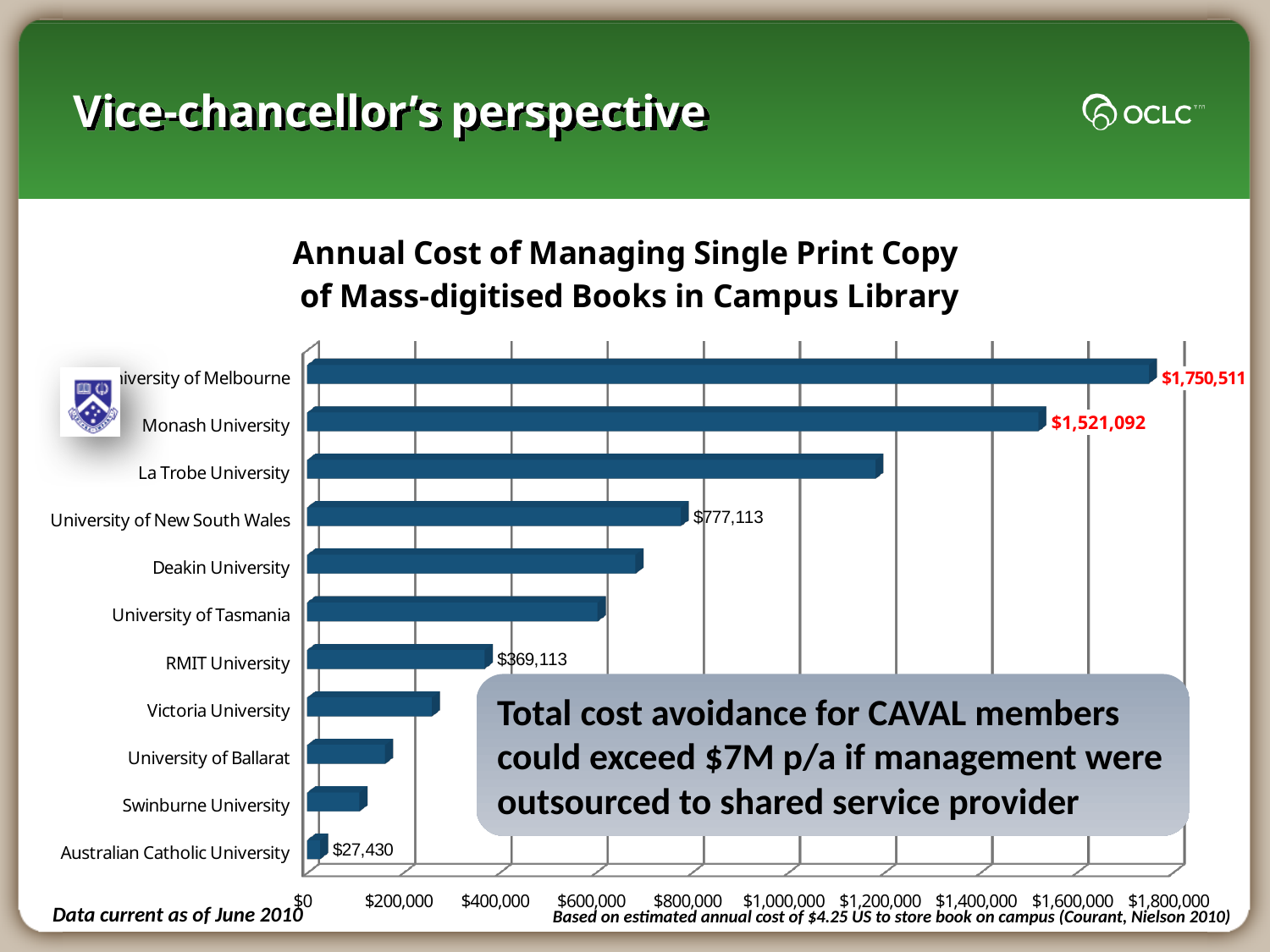
What is the annual cost shown for Australian Catholic University? $27,430 Is the value for University of Ballarat greater or less than $200,000? less What is the annual cost shown for the University of New South Wales? $777,113 What is the annual cost shown for Monash University? $1,521,092 What is the annual cost shown for RMIT University? $369,113 Is the value for Deakin University greater or less than $600,000? greater How many universities are listed on the chart? 11 What is the difference between the annual cost for the University of Melbourne and Monash University? $229,419 What is the annual cost shown for the University of Melbourne? $1,750,511 What kind of chart is shown on the slide? bar chart Which university has the lowest annual cost on the chart? Australian Catholic University Which university has the highest annual cost on the chart? University of Melbourne